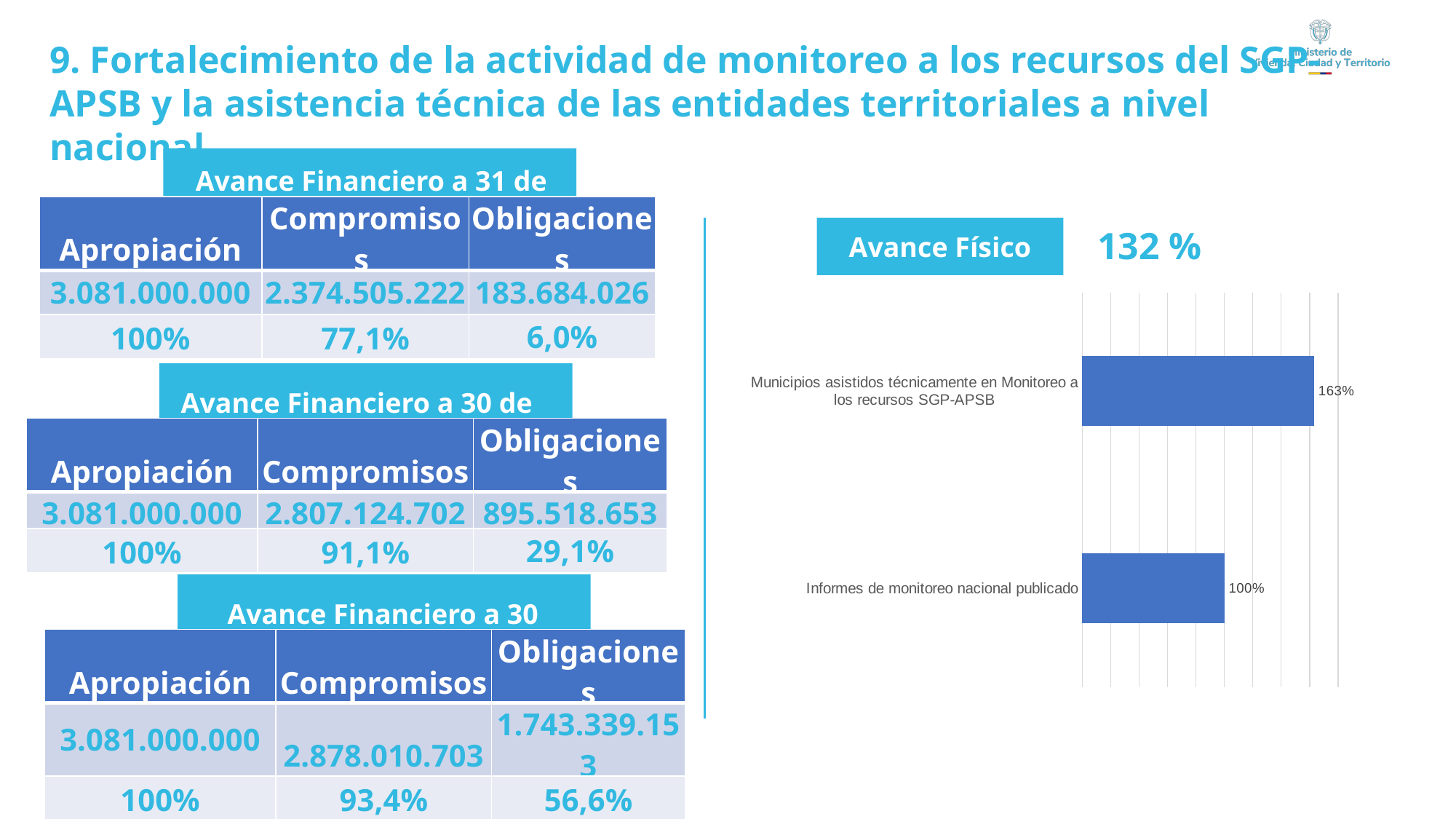
What overall "Avance Físico" percentage is shown next to the bar chart? 132 % How many categories does the bar chart show? 2 Which category has the highest value in the bar chart? Municipios asistidos técnicamente en Monitoreo a los recursos SGP-APSB What is the difference between the values for "Municipios asistidos técnicamente en Monitoreo a los recursos SGP-APSB" and "Informes de monitoreo nacional publicado" in the bar chart? 63% What is the value for "Municipios asistidos técnicamente en Monitoreo a los recursos SGP-APSB" in the bar chart? 163% What type of chart is shown on the right side of the slide? bar chart Are the bars in the chart oriented horizontally or vertically? horizontally Which category has the lowest value in the bar chart? Informes de monitoreo nacional publicado In the bar chart, which is larger: the value for "Municipios asistidos técnicamente en Monitoreo a los recursos SGP-APSB" or for "Informes de monitoreo nacional publicado"? Municipios asistidos técnicamente en Monitoreo a los recursos SGP-APSB What is the value for "Informes de monitoreo nacional publicado" in the bar chart? 100%